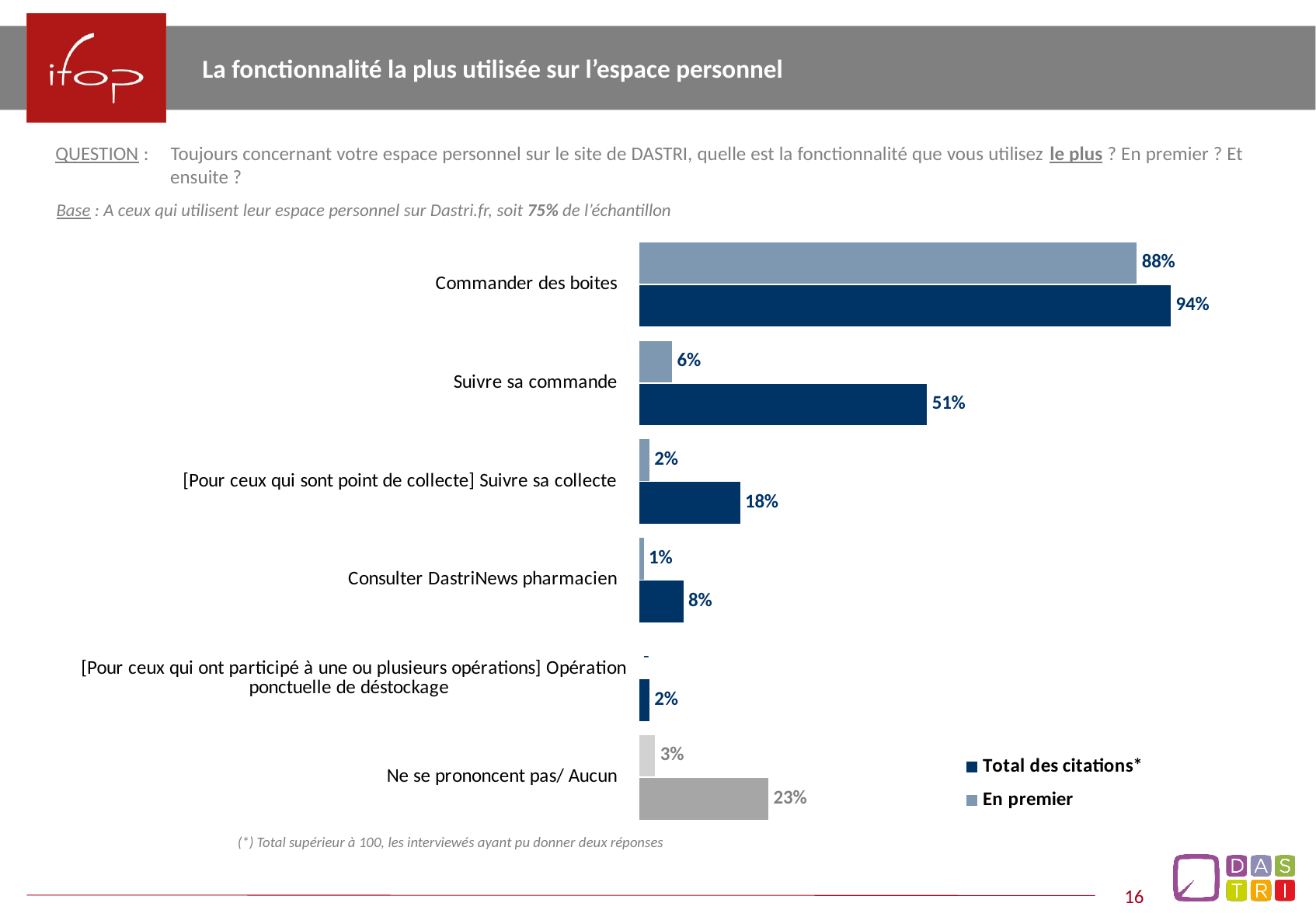
Which category has the highest 'Total des citations' value? Commander des boites What is the 'Total des citations' value for 'Commander des boites'? 94% How many categories are shown in the chart? 6 What kind of chart is shown on the slide? Bar chart What are the two series named in the legend? Total des citations* and En premier What is the 'En premier' value for 'Suivre sa commande'? 6% Which category has the lowest 'Total des citations' value? [Pour ceux qui ont participé à une ou plusieurs opérations] Opération ponctuelle de déstockage What is the difference between the 'Total des citations' and 'En premier' values for 'Suivre sa commande'? 45 percentage points Which is larger: the 'Total des citations' value for 'Suivre sa collecte' or for 'Ne se prononcent pas/ Aucun'? Ne se prononcent pas/ Aucun What is the 'Total des citations' value for 'Consulter DastriNews pharmacien'? 8% What is the 'En premier' value for 'Ne se prononcent pas/ Aucun'? 3% How many series does the legend list? 2